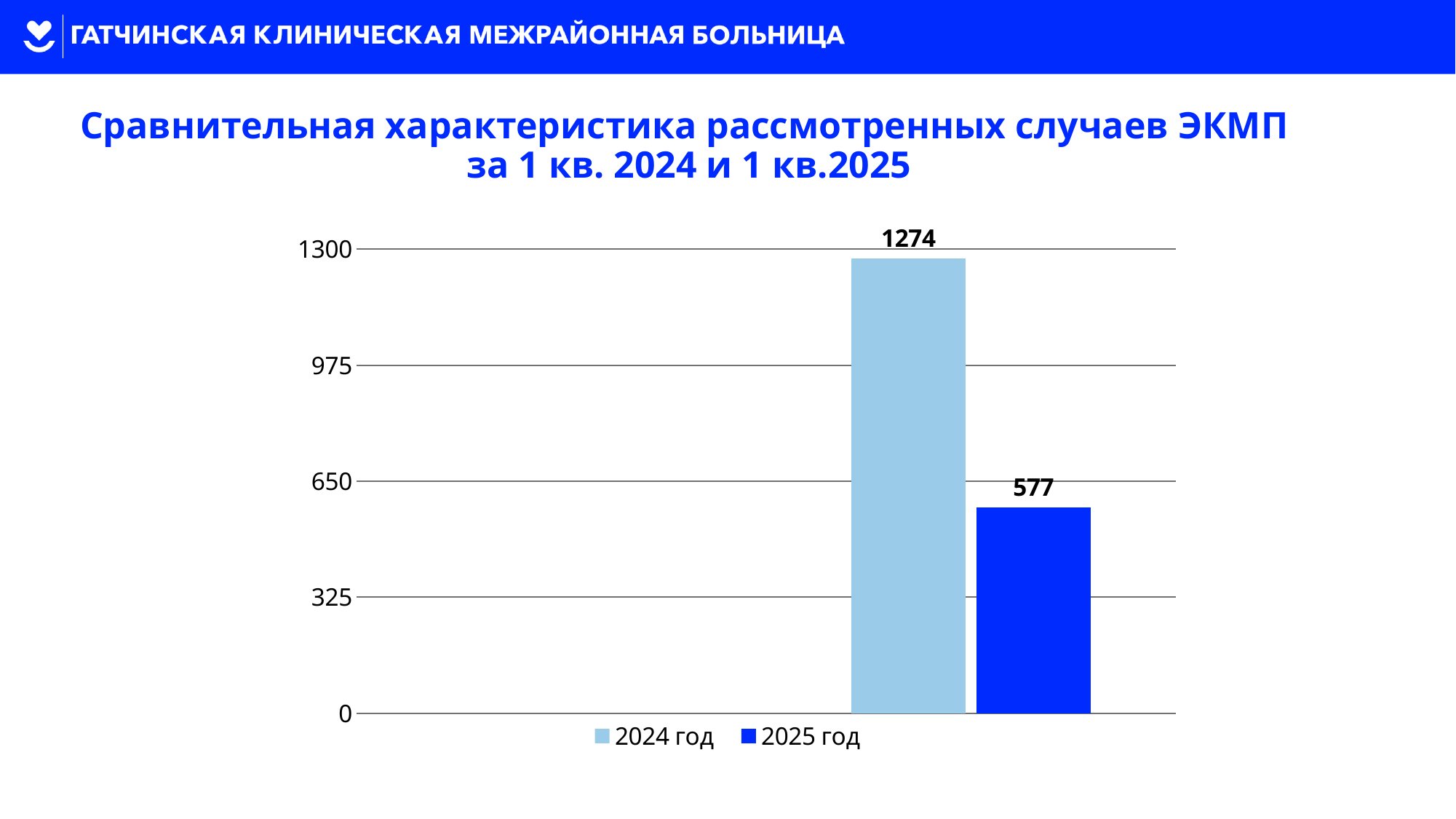
Which is larger, the value for 2024 год or the value for 2025 год? 2024 год Which series has the lowest value? 2025 год How many series does the legend list? 2 What is the value for 2025 год? 577 Which series has the highest value? 2024 год Is the value for 2024 год greater or less than 975? greater What is the difference between the values for 2024 год and 2025 год? 697 What is the title of the chart? Сравнительная характеристика рассмотренных случаев ЭКМП за 1 кв. 2024 и 1 кв.2025 Is the value for 2025 год greater or less than 650? less What is the value for 2024 год? 1274 What kind of chart is shown on the slide? bar chart What colour is the bar for 2025 год? blue